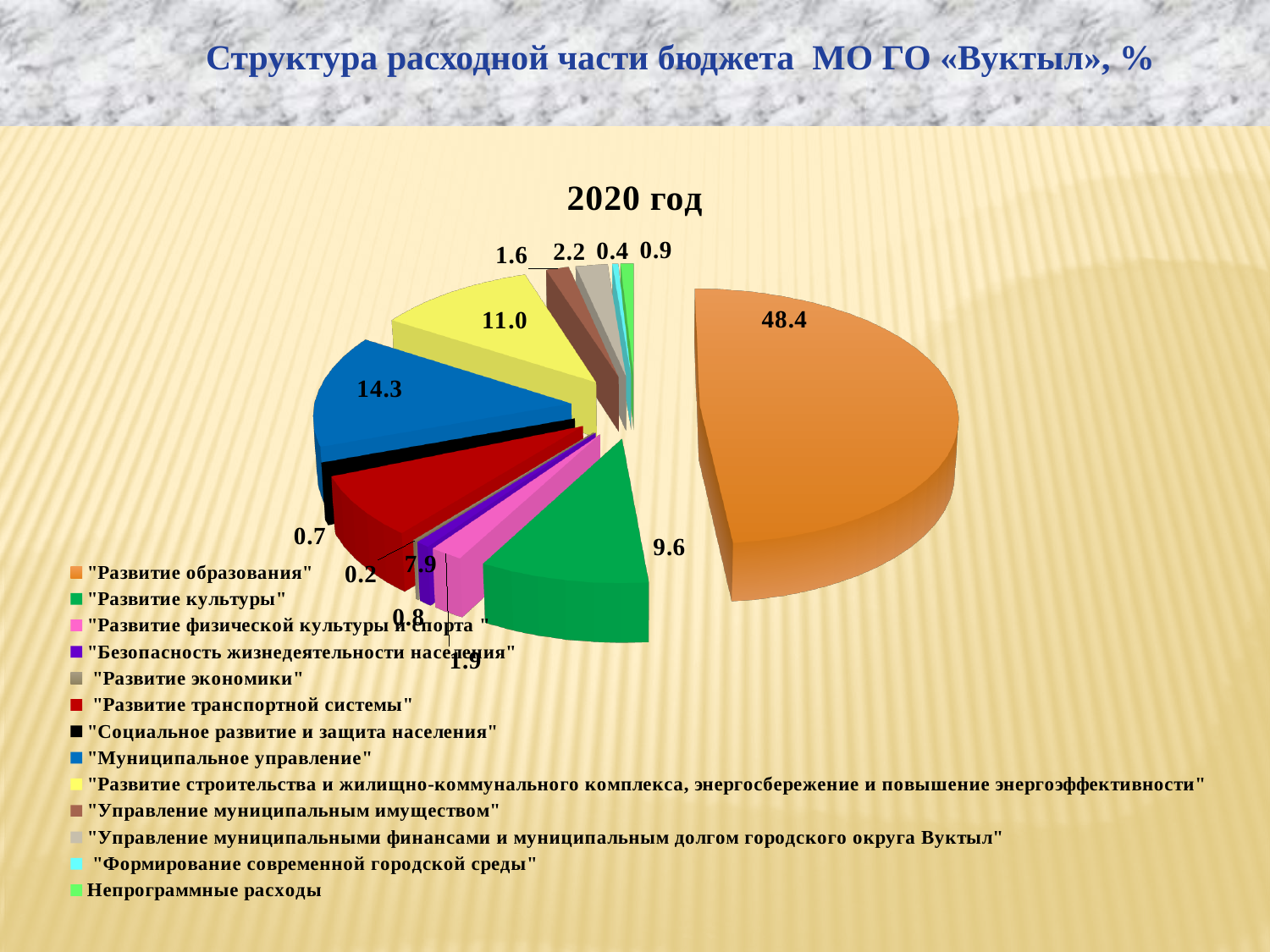
What is the value for "Развитие строительства и жилищно-коммунального комплекса, энергосбережение и повышение энергоэффективности"? 11.0 What is the title shown above the pie chart? 2020 год What is the value for "Развитие образования"? 48.4 Which category has the largest slice of the pie? "Развитие образования" Which is larger: the value for "Развитие культуры" or the value for "Развитие транспортной системы"? "Развитие культуры" What is the value for "Муниципальное управление"? 14.3 How many categories does the legend of the pie chart list? 13 What is the difference between the values for "Муниципальное управление" and "Развитие культуры"? 4.7 What is the value for "Развитие транспортной системы"? 7.9 What is the value for "Развитие культуры"? 9.6 What kind of chart is shown on the slide? pie chart What colour is the slice for "Развитие образования"? orange